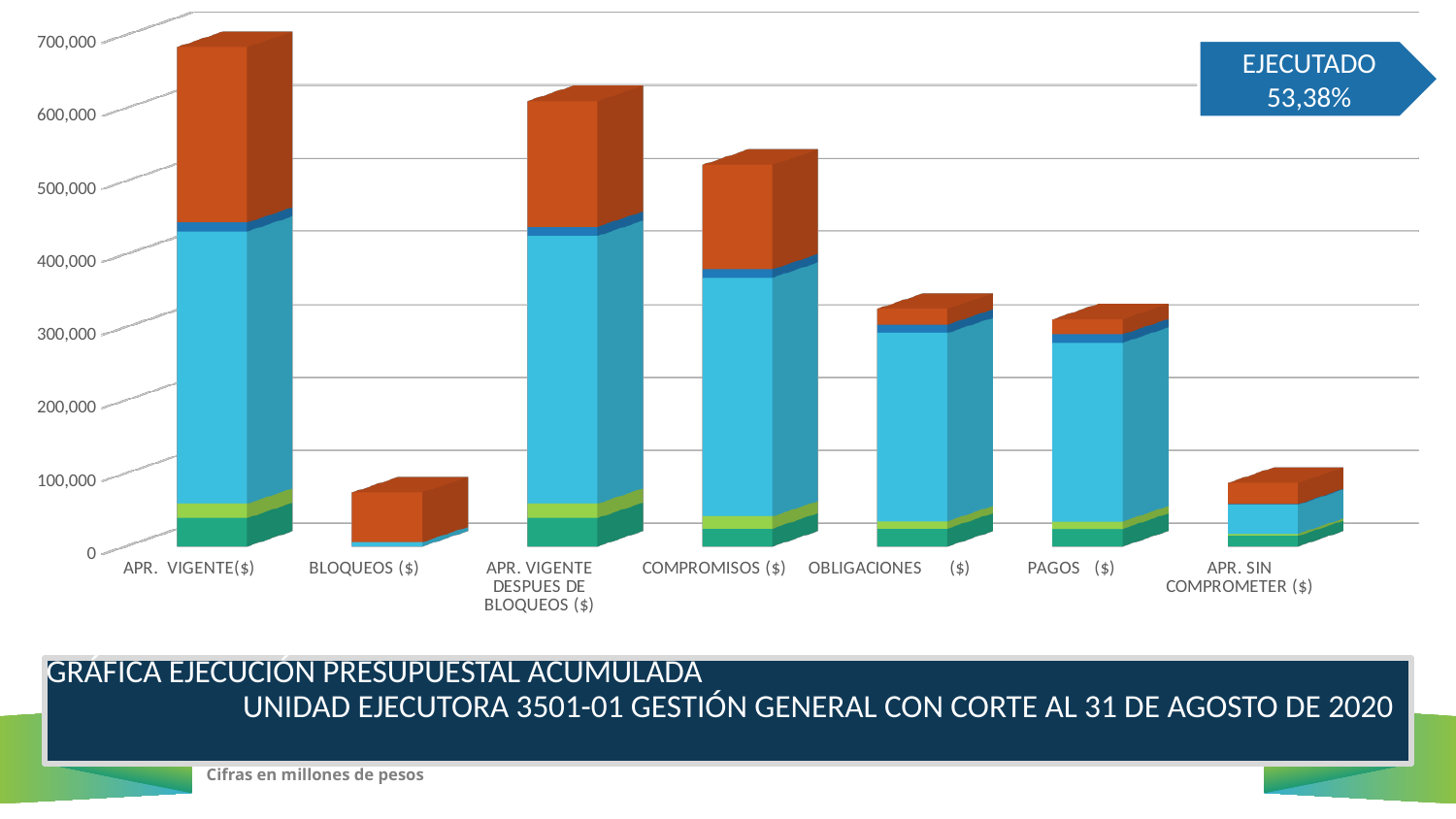
Which stacked bar is taller, APR. VIGENTE($) or APR. VIGENTE DESPUES DE BLOQUEOS ($)? APR. VIGENTE($) Is the total stacked value for APR. VIGENTE DESPUES DE BLOQUEOS ($) greater or less than 500,000? greater In what units are the figures on the chart expressed, according to the note on the slide? Millones de pesos Which stacked bar is taller, COMPROMISOS ($) or OBLIGACIONES ($)? COMPROMISOS ($) What EJECUTADO percentage is shown in the callout on the slide? 53,38% Is the total stacked value for APR. VIGENTE($) greater or less than 600,000? greater Is the total stacked value for OBLIGACIONES ($) greater or less than 400,000? less What kind of chart is shown on the slide? Stacked bar chart How many categories are shown along the x axis of the chart? 7 Which category has the tallest stacked bar? APR. VIGENTE($)